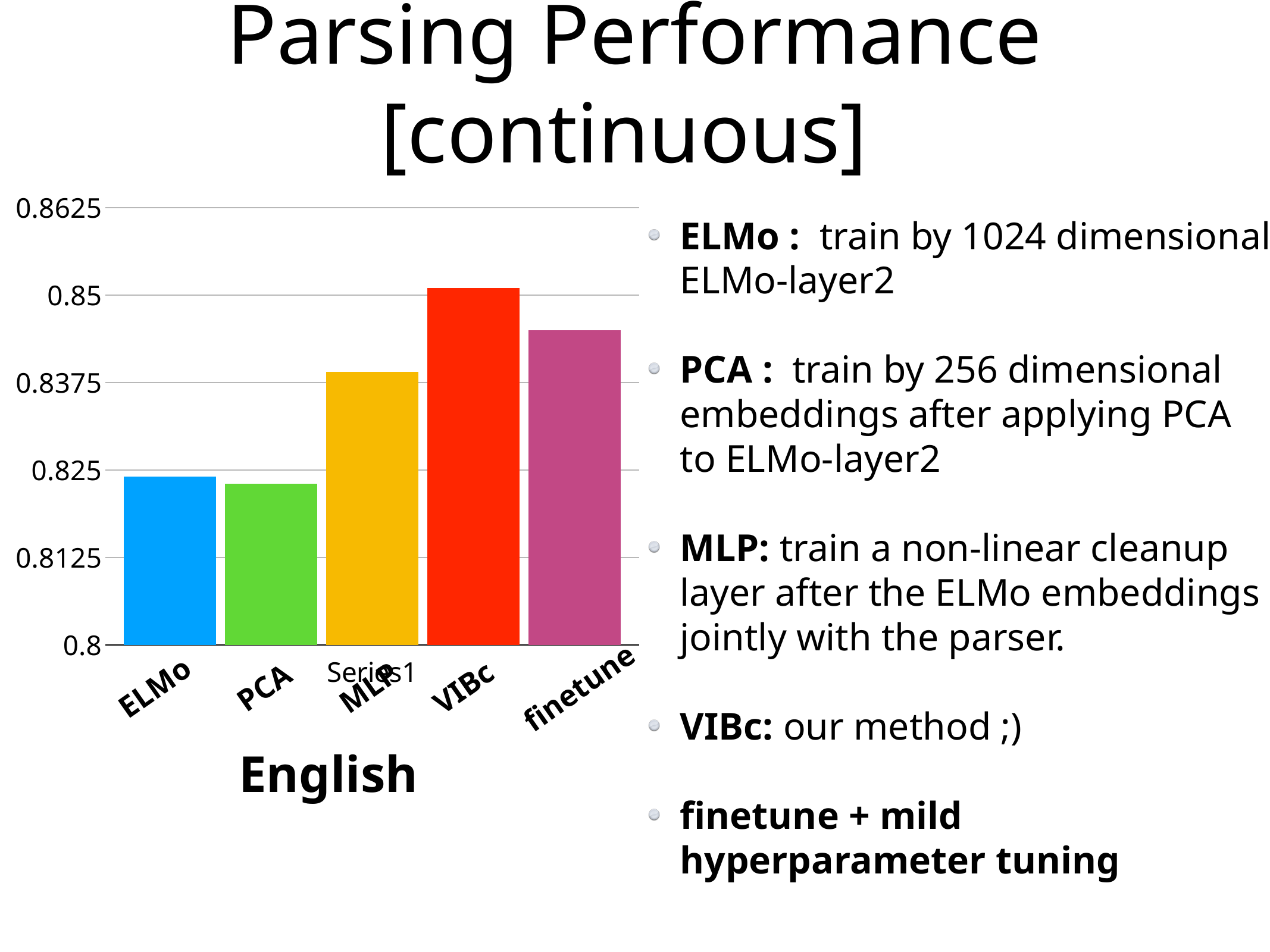
Which is larger, the value for MLP or the value for ELMo? MLP Which is larger, the value for VIBc or the value for finetune? VIBc What series name is shown in the chart's legend? Series1 Which category has the highest bar in the chart? VIBc What kind of chart is shown on the slide? bar chart How many categories are plotted in the bar chart? 5 Do the values rise or fall from PCA to VIBc along the x axis? rise What label appears below the x axis of the chart? English Is the value for MLP greater or less than 0.8375? greater Is the value for finetune greater or less than 0.85? less Is the value for PCA greater or less than 0.825? less